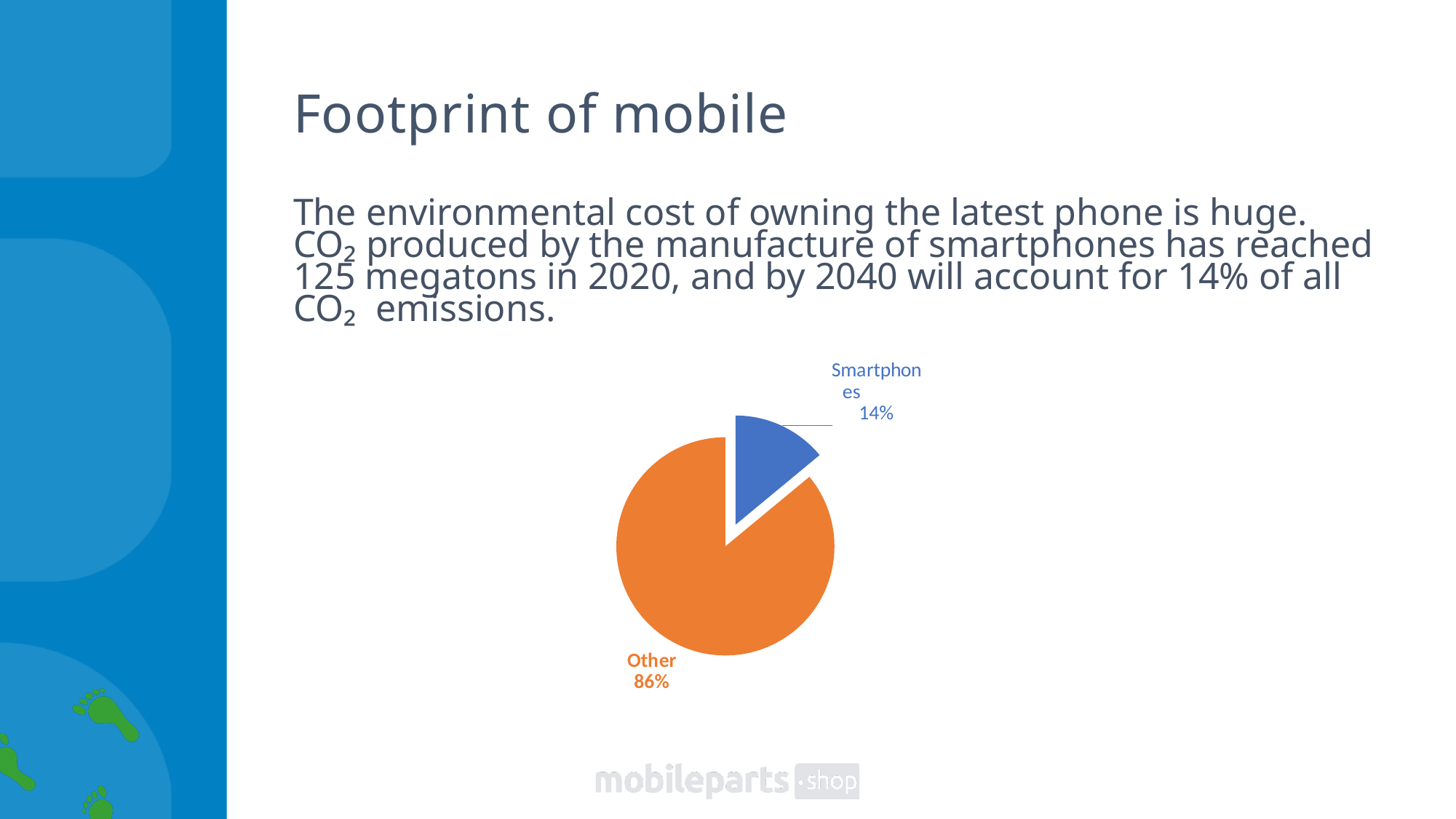
What colour is the Other slice? orange Is the share for Other greater or less than 50%? greater Which slice of the pie is the largest? Other Which is larger, the Smartphones slice or the Other slice? Other What colour is the Smartphones slice? blue What is the difference in percentage points between the Other slice and the Smartphones slice? 72 What kind of chart is shown on the slide? pie chart What share of the pie does the Other slice represent? 86% Which slice of the pie is the smallest? Smartphones How many slices does the pie chart have? 2 What share of the pie does the Smartphones slice represent? 14%